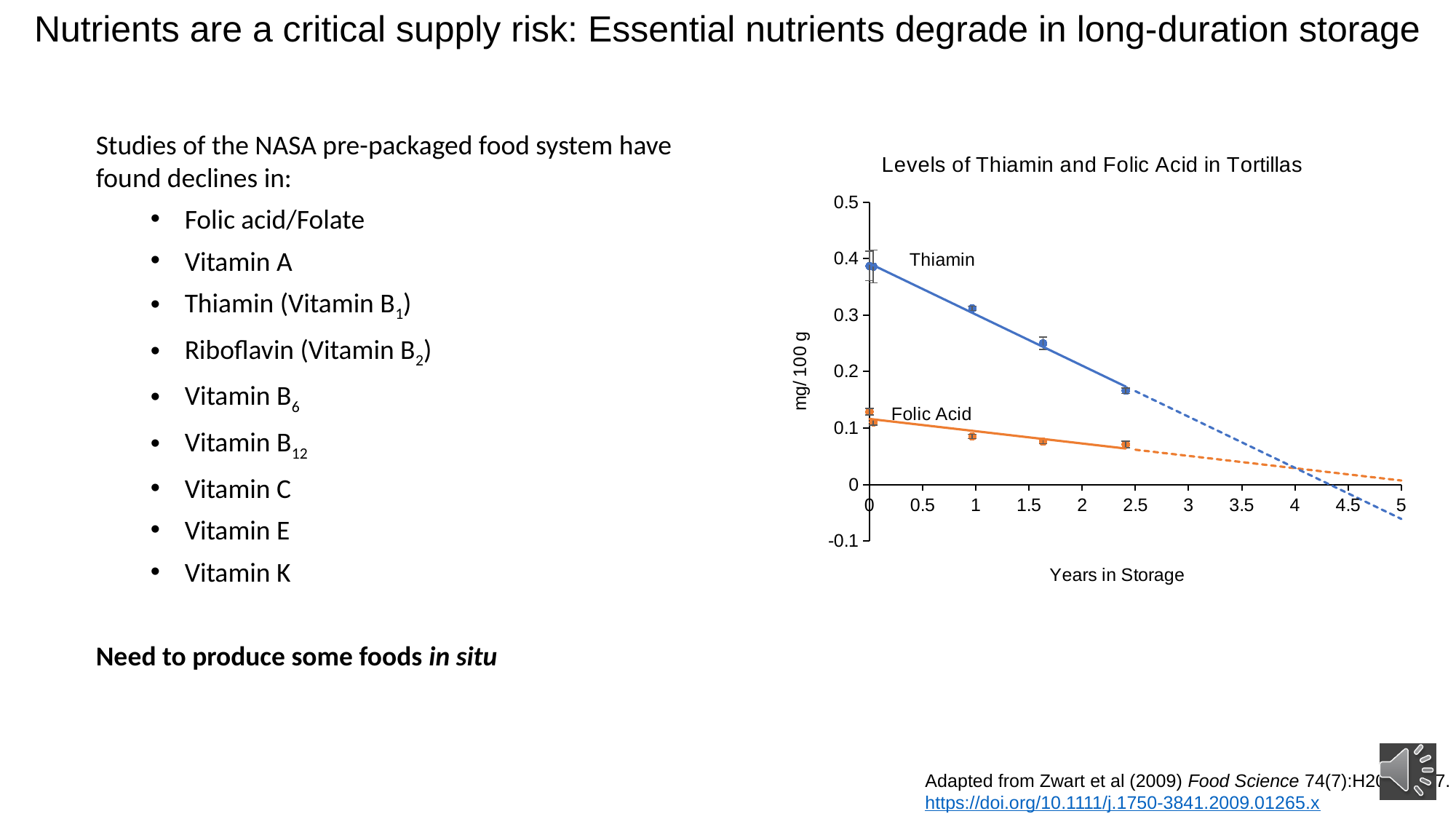
Do the Folic Acid values rise or fall as years in storage increase? Fall What is the label of the y axis? mg/ 100 g What type of chart is shown on the slide? Line chart (scatter with trend lines) Which series has the higher value at 0 years in storage, Thiamin or Folic Acid? Thiamin Is the Folic Acid value at about 2.5 years in storage greater or less than 0.1? less Is the Thiamin value at 0 years in storage greater or less than 0.3? greater Do the Thiamin values rise or fall as years in storage increase? Fall How many series are plotted on the chart? 2 Is the Thiamin value at about 2.5 years in storage greater or less than 0.2? less What is the title of the chart? Levels of Thiamin and Folic Acid in Tortillas